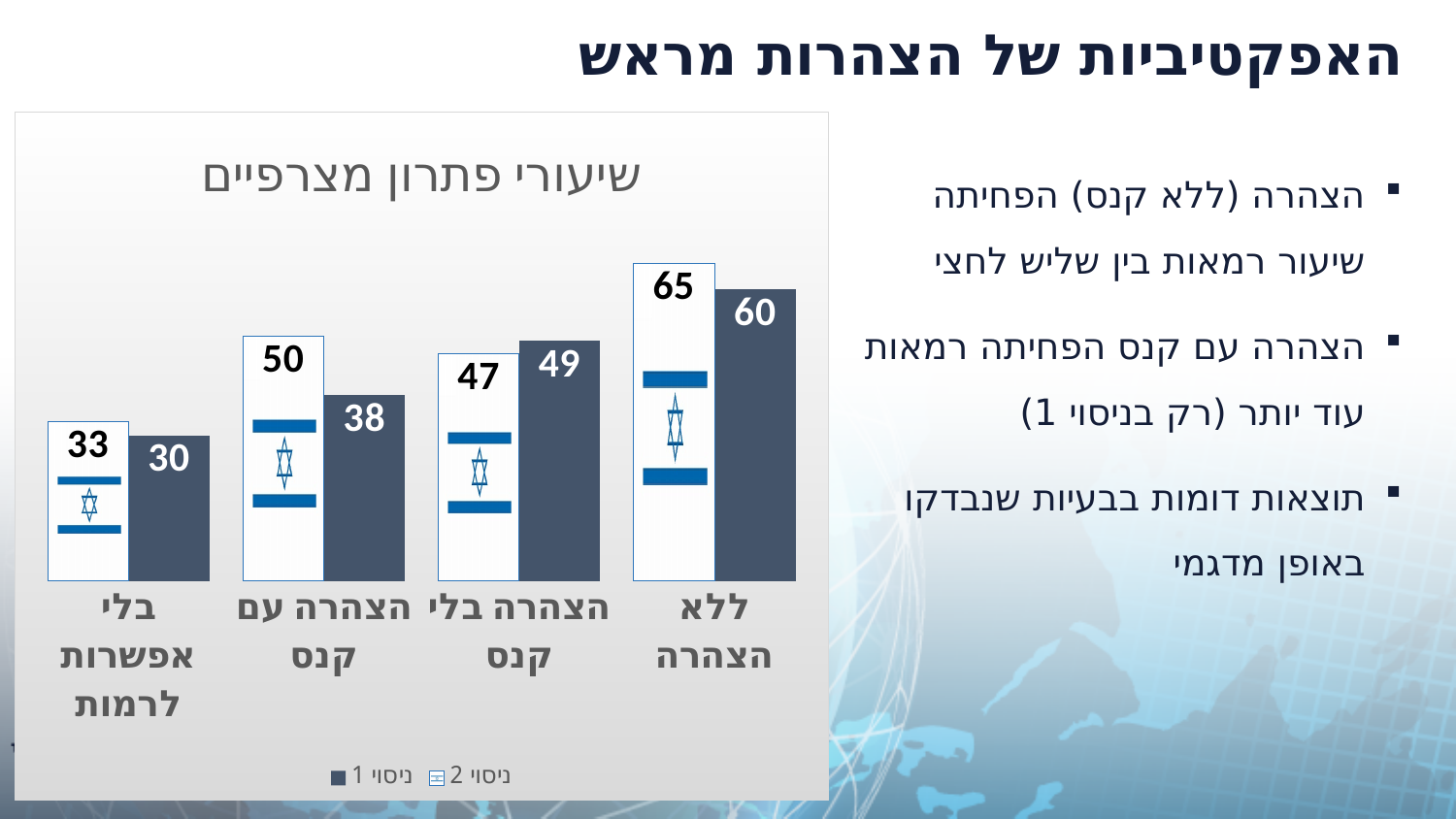
For הצהרה בלי קנס, which series has the larger value, ניסוי 1 (dark) or ניסוי 2 (flag-patterned)? ניסוי 1 What type of chart is shown on the slide? bar chart Which category has the highest value for the ניסוי 2 (flag-patterned) series? ללא הצהרה How many series does the chart legend list? 2 What is the title of the chart? שיעורי פתרון מצרפיים What is the value of the ניסוי 1 (dark) bar for ללא הצהרה? 60 What is the value of the ניסוי 1 (dark) bar for הצהרה עם קנס? 38 How many categories are shown on the x axis of the chart? 4 Which category has the lowest value for the ניסוי 1 (dark) series? בלי אפשרות לרמות What is the value of the ניסוי 2 (flag-patterned) bar for בלי אפשרות לרמות? 33 What is the value of the ניסוי 2 (flag-patterned) bar for ללא הצהרה? 65 What is the difference between the ניסוי 2 and ניסוי 1 values for הצהרה עם קנס? 12